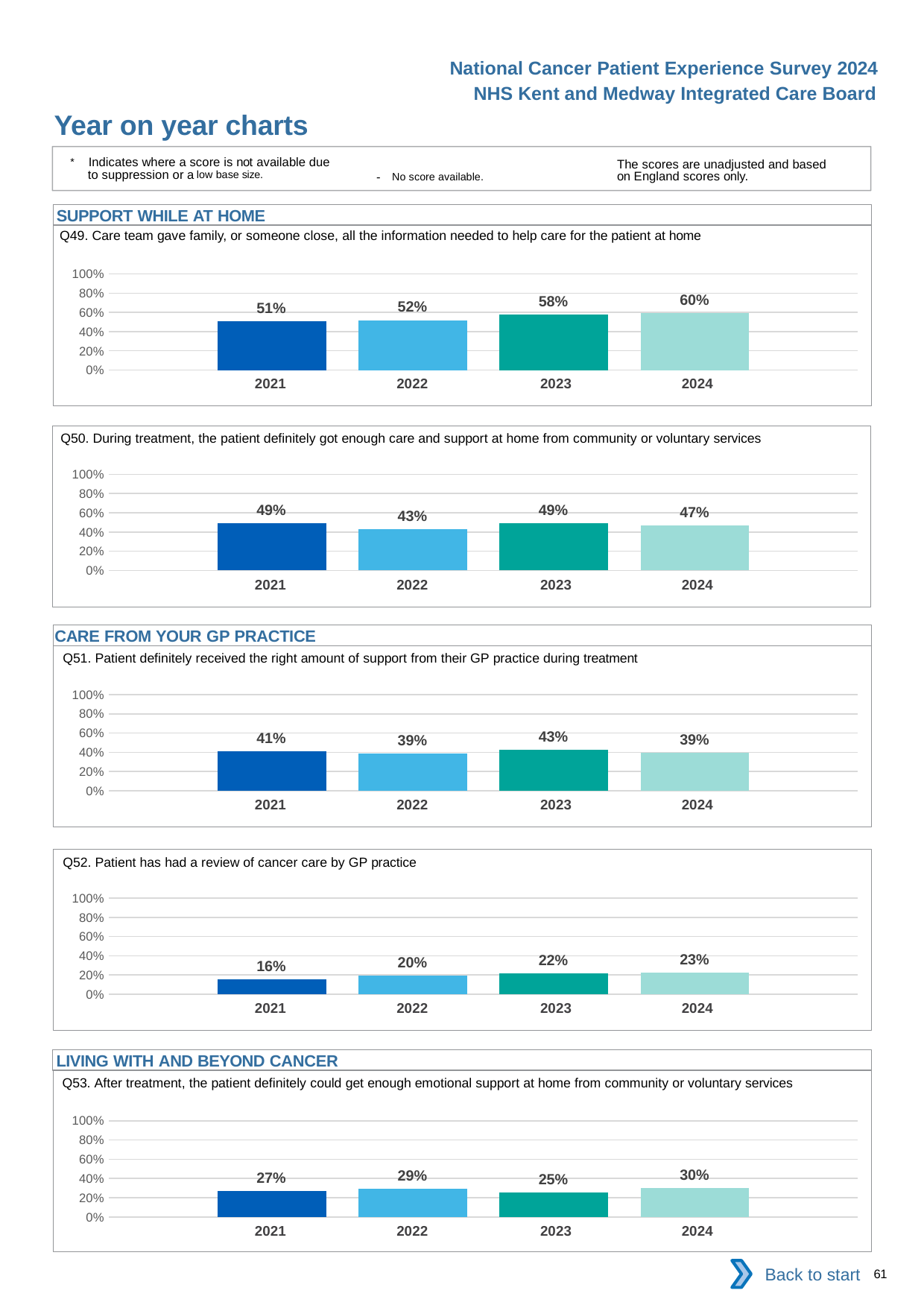
In the Q53 chart, which year has the lowest value? 2023 In the Q50 chart, what is the value for 2022? 43% In the Q50 chart, what is the difference between the 2023 and 2024 values? 2% In the Q52 chart, do the values rise or fall from 2021 to 2024? rise In the Q49 chart, which year has the lowest value? 2021 How many years are shown in the Q49 chart? 4 In the Q49 chart, what is the value for 2024? 60% In the Q53 chart, what is the difference between the 2024 and 2023 values? 5% In the Q51 chart, which year has the highest value? 2023 In the Q51 chart, is the value for 2021 larger or smaller than the value for 2022? larger In the Q52 chart, what is the value for 2021? 16% What type of chart is used for Q52? bar chart